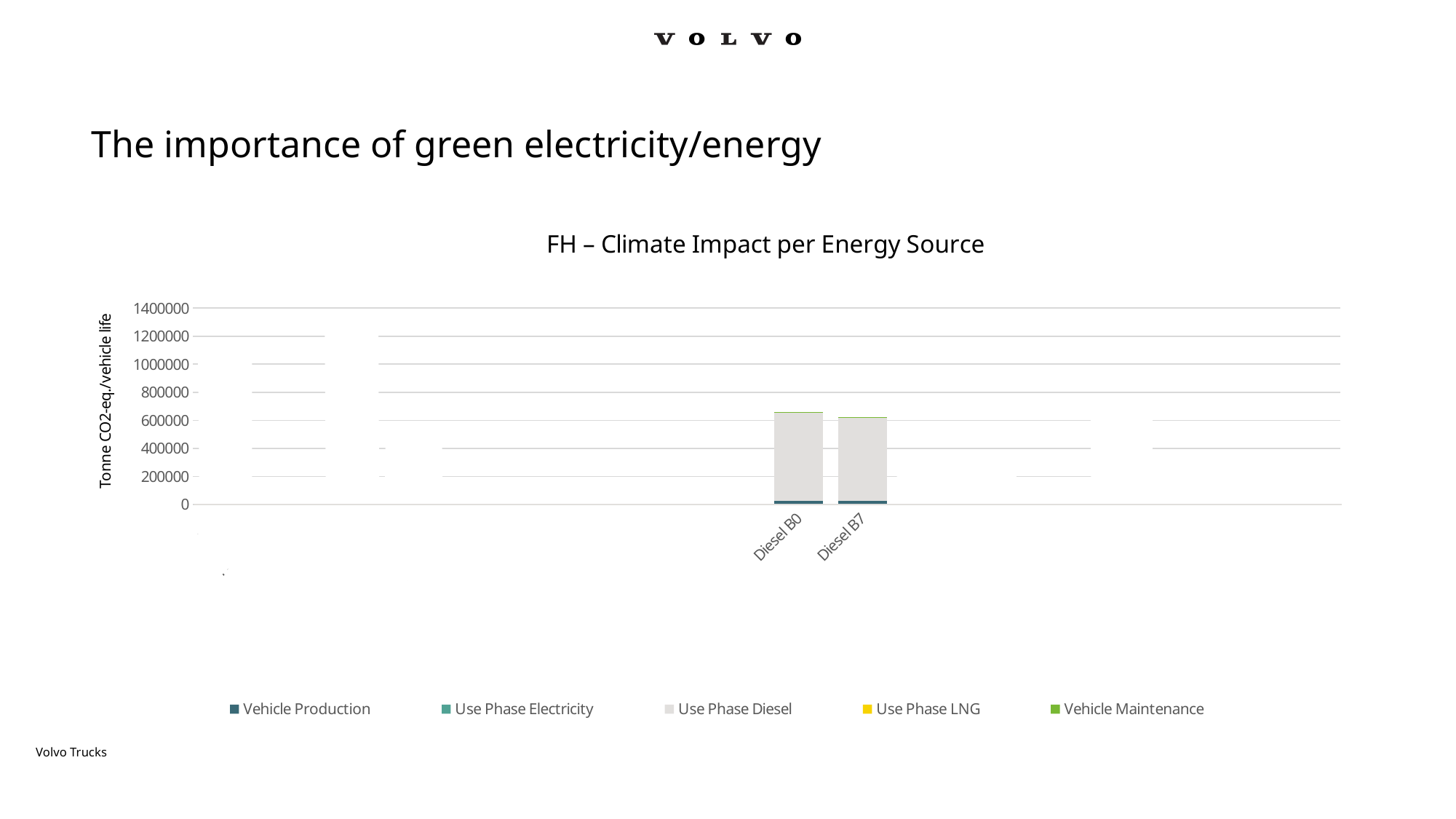
How many categories have bars plotted in the chart? 2 Is the total value for Diesel B0 greater or less than 800000? less What kind of chart is shown on the slide? Bar chart What is the label of the vertical axis? Tonne CO2-eq./vehicle life Is the total value for Diesel B7 greater or less than 800000? less Is the total value for Diesel B0 greater or less than 600000? greater Which series makes up the largest part of the Diesel B0 bar? Use Phase Diesel How many series does the chart legend list? 5 Which bar is taller, Diesel B0 or Diesel B7? Diesel B0 Which category has the highest total climate impact? Diesel B0 What is the title of the chart? FH – Climate Impact per Energy Source